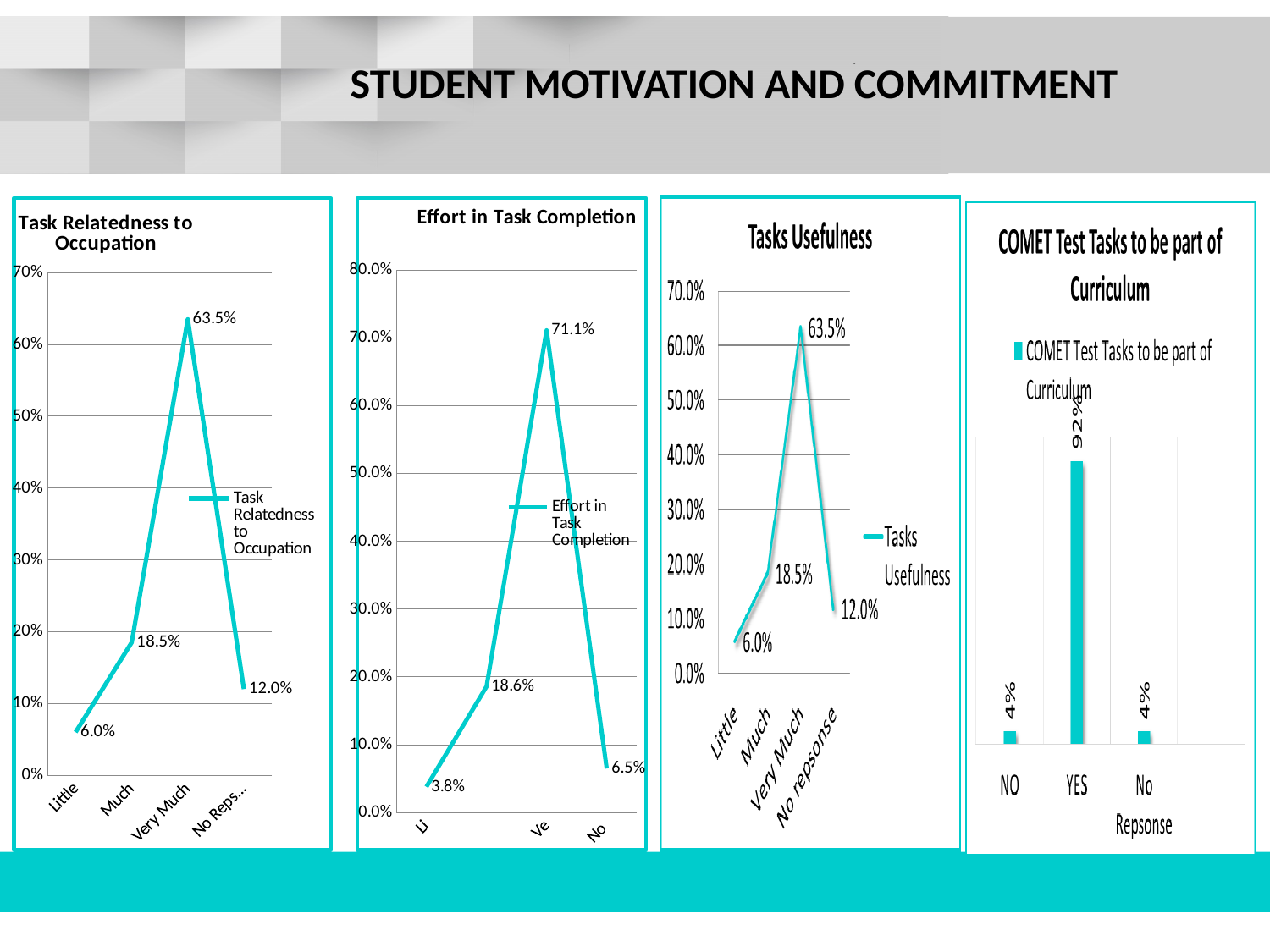
In the 'COMET Test Tasks to be part of Curriculum' chart, what is the value for YES? 92% How many charts are shown on the slide? 4 What kind of chart is 'COMET Test Tasks to be part of Curriculum'? Bar chart What kind of chart is 'Effort in Task Completion'? Line chart In the 'Tasks Usefulness' chart, what is the value for Much? 18.5% In the 'Tasks Usefulness' chart, which is larger, the value for No response or the value for Little? No response In the 'Task Relatedness to Occupation' chart, what is the value for Very Much? 63.5% In the 'Task Relatedness to Occupation' chart, what is the difference between the values for Very Much and Much? 45.0% In the 'Effort in Task Completion' chart, what is the highest value plotted? 71.1% In the 'Task Relatedness to Occupation' chart, what is the value for Little? 6.0% In the 'Tasks Usefulness' chart, which category has the highest value? Very Much In the 'Effort in Task Completion' chart, what is the lowest value plotted? 3.8%